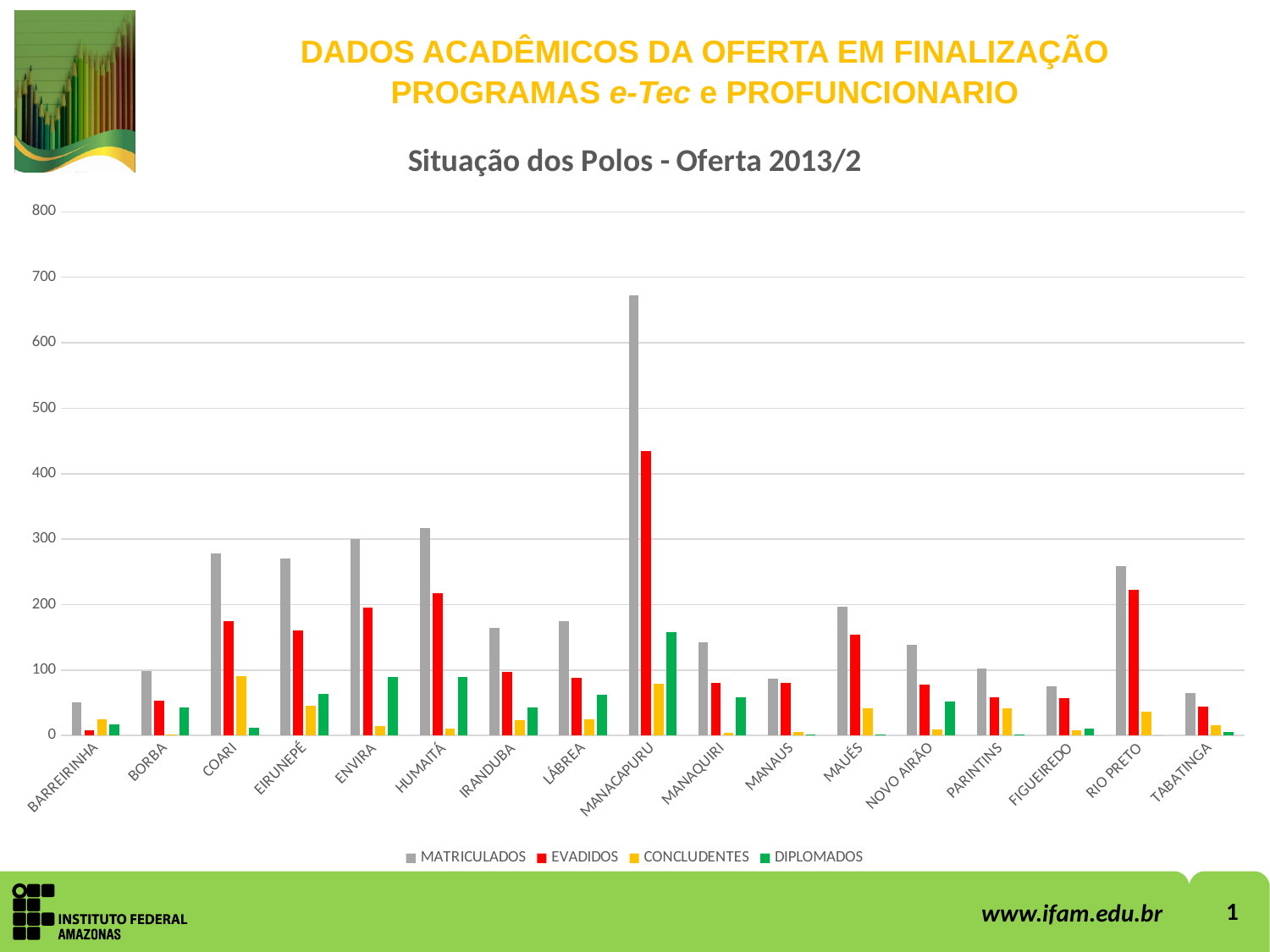
What is the title of the chart? Situação dos Polos - Oferta 2013/2 Which polo has the highest MATRICULADOS value? MANACAPURU Is the MATRICULADOS value for RIO PRETO greater or less than 200? greater Which polo has the highest EVADIDOS value? MANACAPURU What kind of chart is shown on the slide? bar chart Is the MATRICULADOS value for BORBA greater or less than 200? less Which polo has the lowest MATRICULADOS value? BARREIRINHA How many polos (categories) are shown on the x axis? 17 How many series does the legend list? 4 Which is larger, the MATRICULADOS value for RIO PRETO or for MAUÉS? RIO PRETO Is the EVADIDOS value for MANACAPURU greater or less than 400? greater